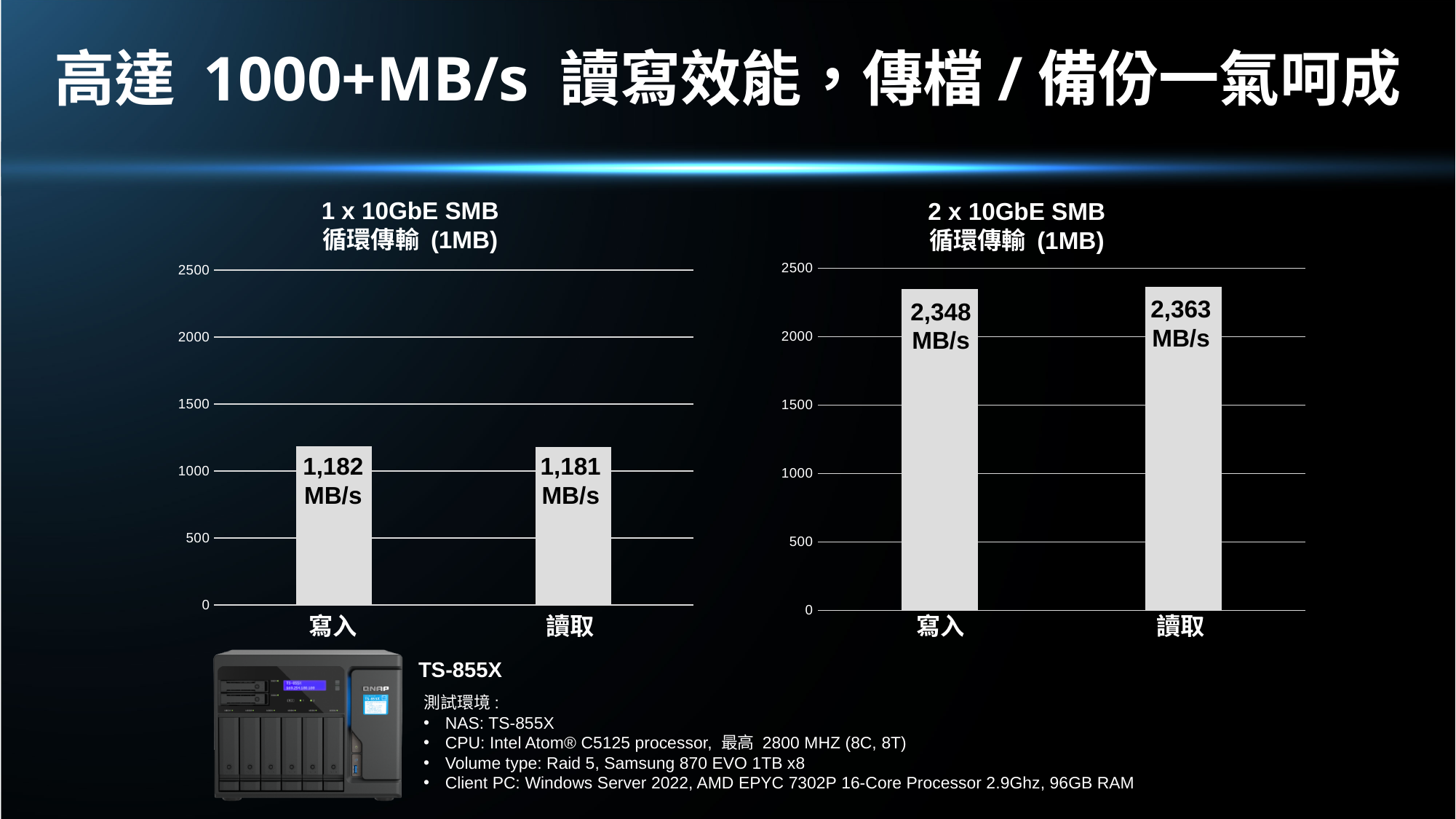
In the left chart (1 x 10GbE SMB), what is the difference between the 寫入 and 讀取 values? 1 MB/s What is the title of the left chart? 1 x 10GbE SMB 循環傳輸 (1MB) In the right chart (2 x 10GbE SMB), what is the value for 讀取? 2,363 MB/s In the left chart (1 x 10GbE SMB), what is the value for 讀取? 1,181 MB/s What kind of chart is the right chart (2 x 10GbE SMB)? Bar chart In the right chart (2 x 10GbE SMB), is the value for 寫入 greater or less than 2000? greater In the right chart (2 x 10GbE SMB), what is the difference between the 讀取 and 寫入 values? 15 MB/s What is the highest value shown on the y axis of the right chart (2 x 10GbE SMB)? 2500 How many categories does the left chart (1 x 10GbE SMB) show? 2 In the right chart (2 x 10GbE SMB), what is the value for 寫入? 2,348 MB/s In the left chart (1 x 10GbE SMB), is the value for 讀取 greater or less than 1500? less In the left chart (1 x 10GbE SMB), what is the value for 寫入? 1,182 MB/s